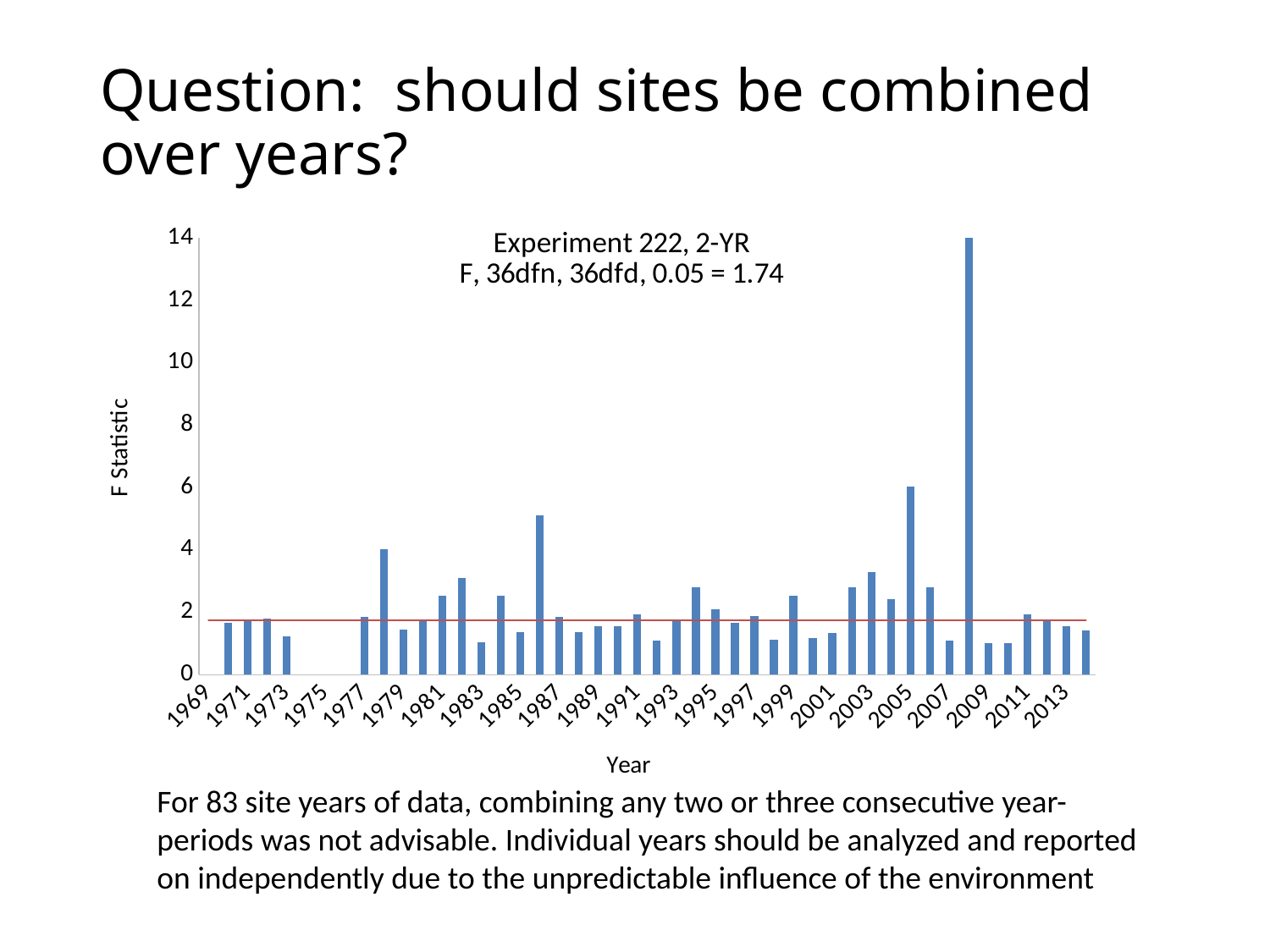
Is the F Statistic for 1978 greater or less than 2? greater What critical F value is stated in the chart title? 1.74 Is the F Statistic for 2005 greater or less than 4? greater What kind of chart is shown on the slide? bar chart What is the label on the vertical axis of the chart? F Statistic Is the F Statistic for 1986 greater or less than 4? greater Which year has the larger F Statistic, 1978 or 1982? 1978 Which year has the highest F Statistic? 2008 Which year has the larger F Statistic, 2005 or 1986? 2005